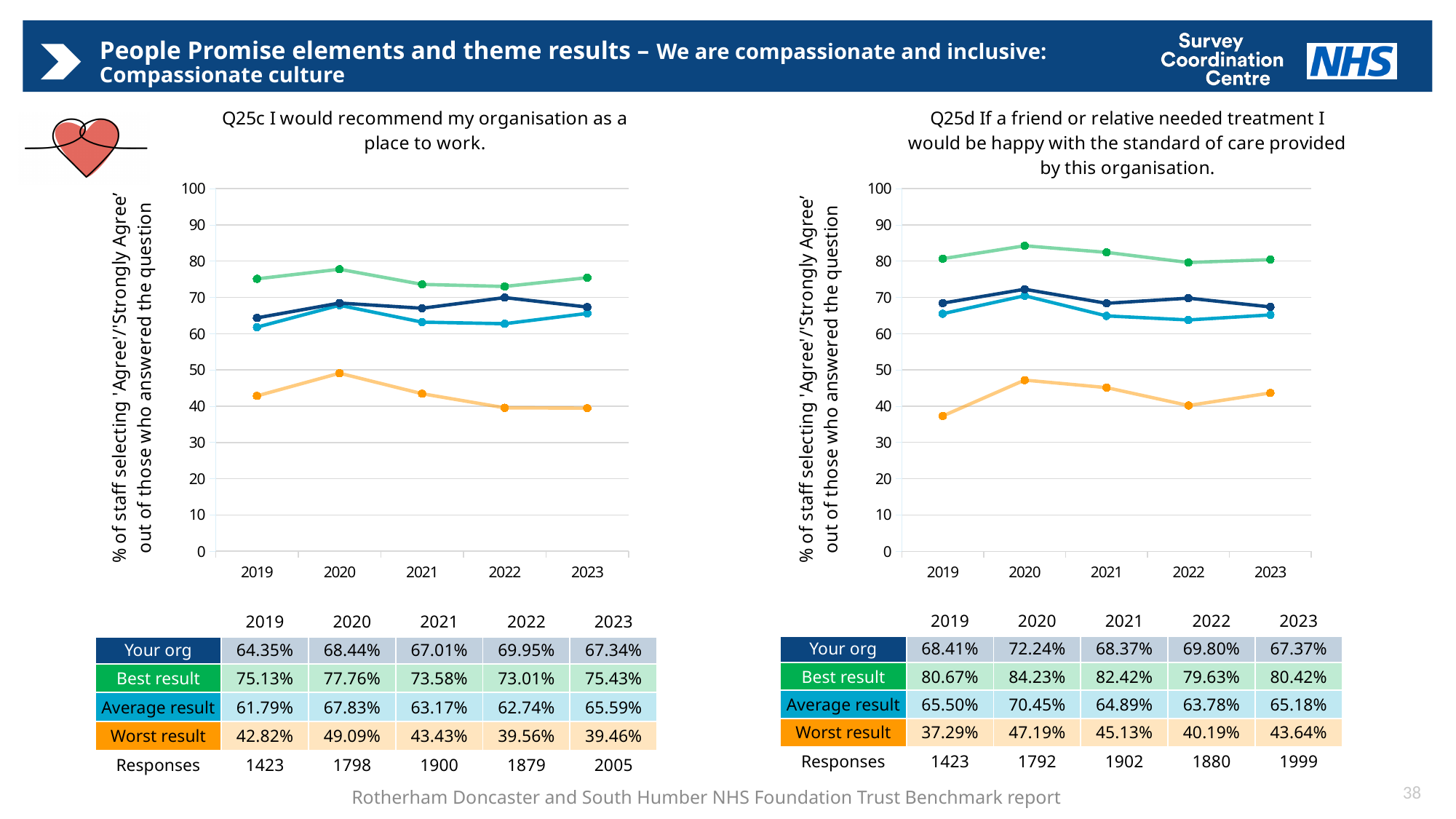
In the Q25d chart, which year had the lowest 'Your org' value? 2023 In the Q25d chart, which is larger: the 'Average result' in 2019 or the 'Average result' in 2021? 2019 In the Q25d chart, what was the 'Best result' value in 2020? 84.23% In the Q25d chart, is the 'Worst result' value for 2019 greater or less than 40? less In the Q25c chart, which year had the highest 'Worst result' value? 2020 In the Q25c chart, did the 'Your org' value rise or fall from 2022 to 2023? fall In the Q25c chart, what was the 'Your org' value in 2022? 69.95% What type of chart is used for Q25c? Line chart In the Q25c chart, what is the difference between the 'Best result' and 'Your org' values in 2023? 8.09% In the Q25d chart, how many responses were recorded in 2023? 1999 How many years are plotted on the x axis of the Q25c chart? 5 How many series are plotted in the Q25d chart? 4